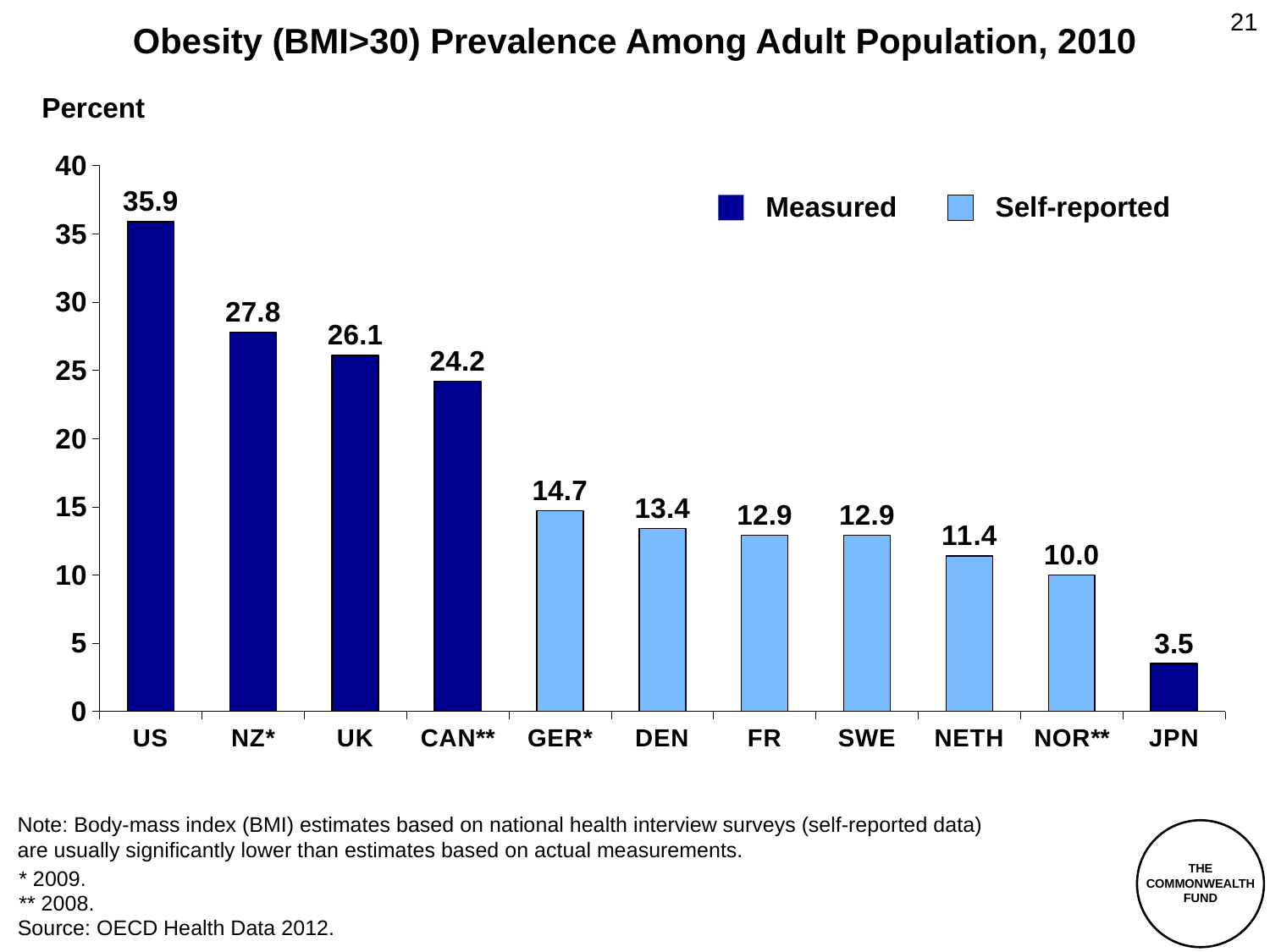
What is the difference between the values for the US and NZ*? 8.1 What is the value shown for GER*? 14.7 Which has a higher value, DEN or NETH? DEN Which country has the highest obesity prevalence on the chart? US How many countries are shown on the chart? 11 How many series does the legend list? 2 Which country has the lowest obesity prevalence on the chart? JPN Is the value for CAN** greater or less than 25? less What type of chart is shown on the slide? Bar chart What is the value shown for NOR**? 10.0 What is the difference between the values for UK and CAN**? 1.9 What is the obesity prevalence value shown for the US? 35.9